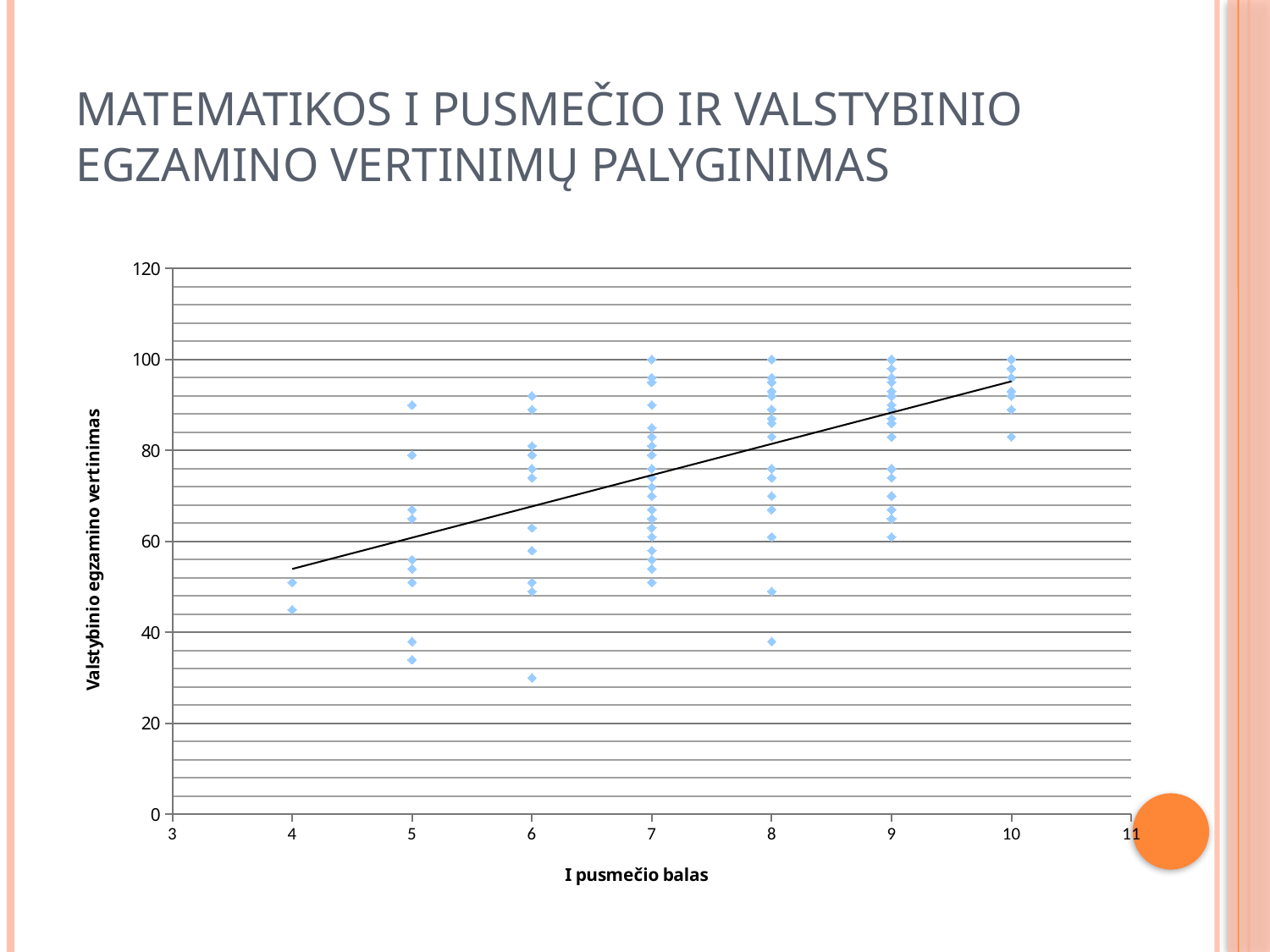
What is the title of the x axis? I pusmečio balas What kind of chart is shown on the slide? scatter chart Is the trend line value at I pusmečio balas 10 greater or less than 80? greater Is the lowest plotted value for I pusmečio balas 4 greater or less than 60? less Is the lowest plotted value for I pusmečio balas 10 greater or less than 80? greater How many distinct x-axis values (I pusmečio balas) have plotted points? 7 What is the title of the y axis? Valstybinio egzamino vertinimas Does the trend line rise or fall as the x-axis value (I pusmečio balas) increases? rises